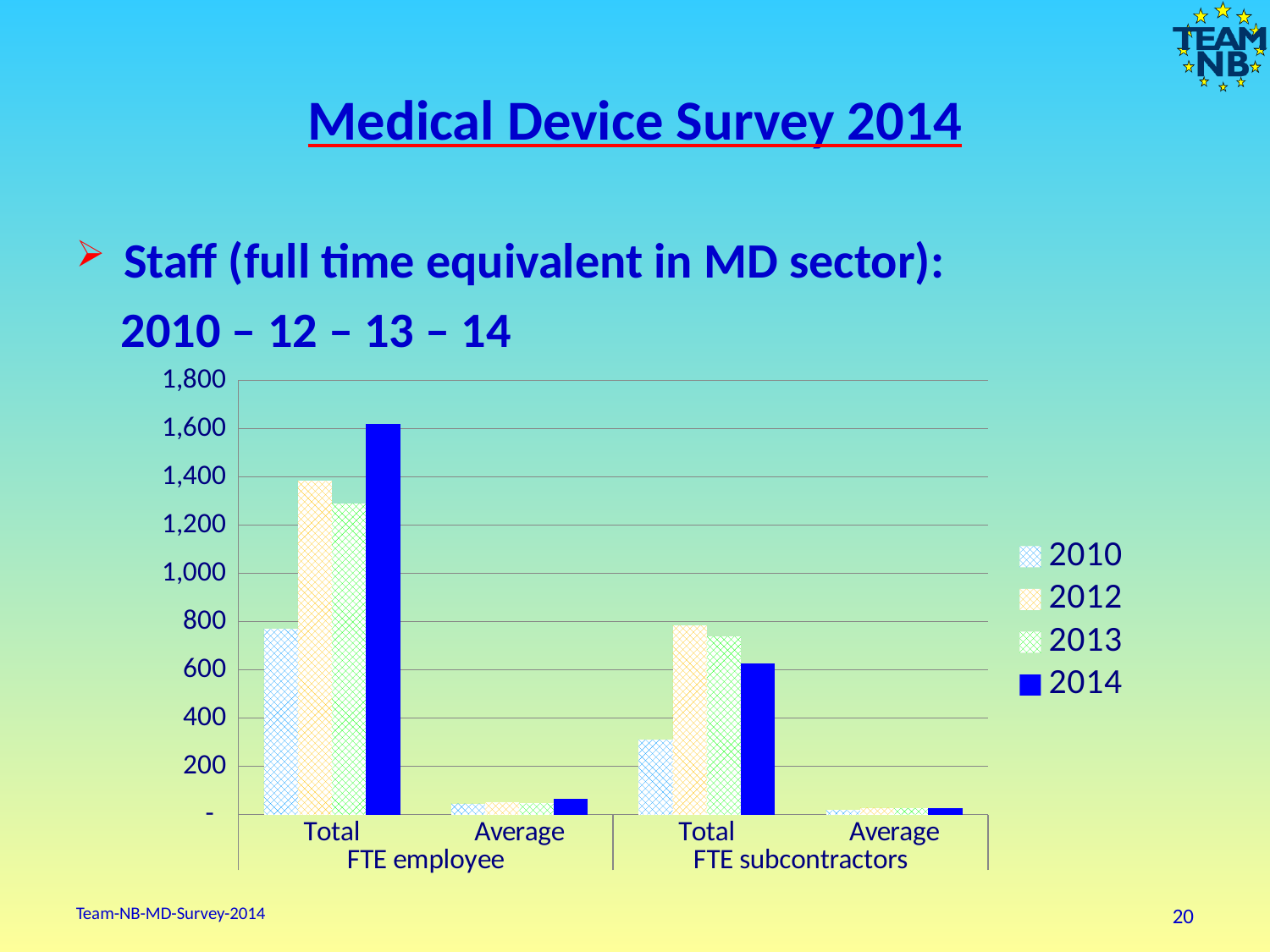
Is the 2010 value for Total FTE employee greater or less than 1,000? less Which years are listed in the chart legend? 2010, 2012, 2013, 2014 Is the 2012 value for Total FTE employee greater or less than 1,200? greater For 2014, which is larger: Total FTE employee or Total FTE subcontractors? Total FTE employee What kind of chart is shown on the slide? bar chart Which year has the lowest Total FTE subcontractors value? 2010 Which year has the lowest Total FTE employee value? 2010 How many series does the legend list? 4 How many category groups are shown along the x axis? 4 Is the 2014 value for Total FTE employee greater or less than 1,400? greater Which year has the highest Total FTE employee value? 2014